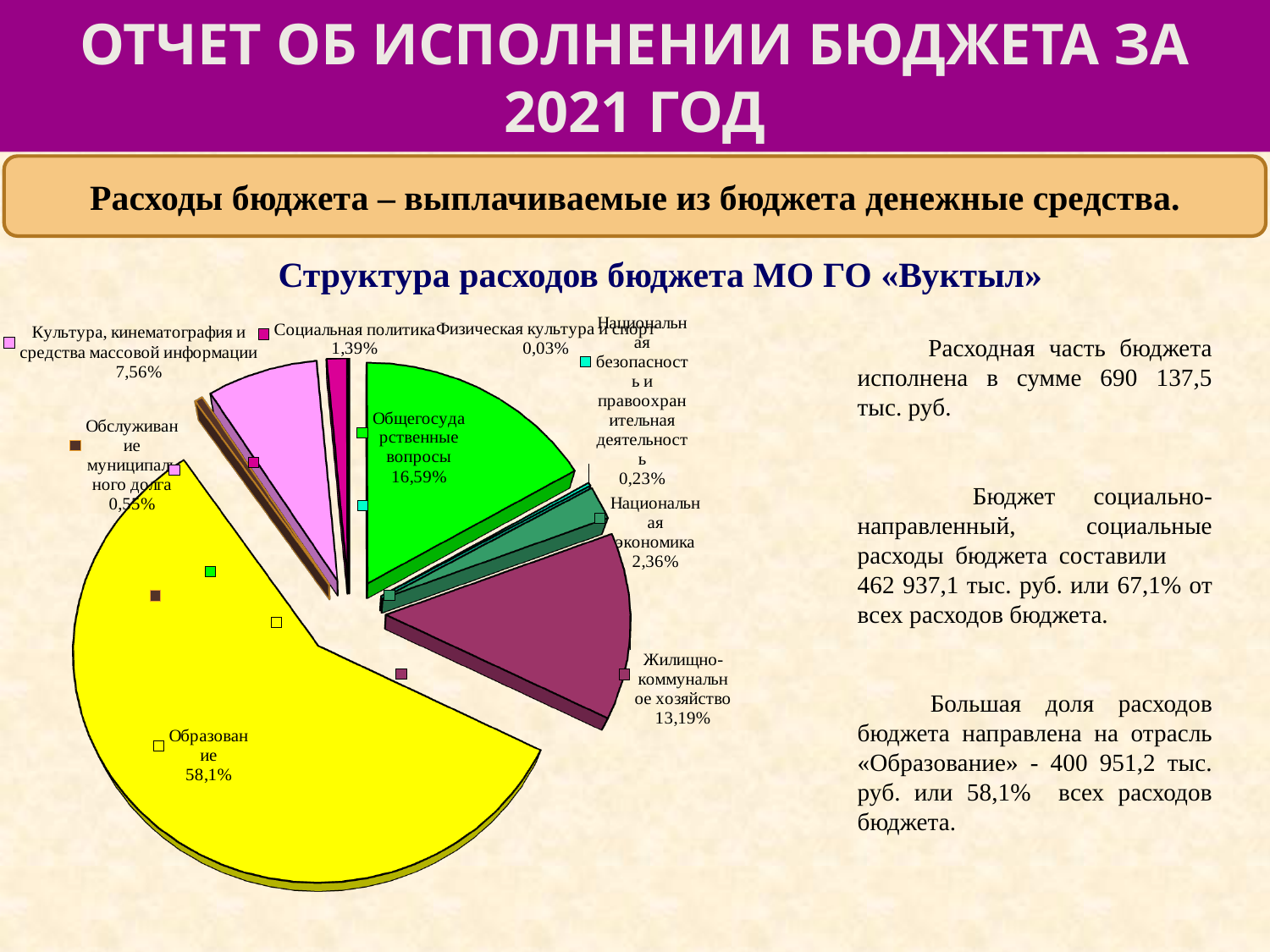
What share of the pie does «Жилищно-коммунальное хозяйство» have? 13,19% What share of the pie does «Культура, кинематография и средства массовой информации» have? 7,56% How many categories are shown in the pie chart? 9 What share of the pie does «Образование» have? 58,1% Which is larger: the share of «Общегосударственные вопросы» or the share of «Жилищно-коммунальное хозяйство»? Общегосударственные вопросы What kind of chart is shown on the slide? pie chart What share of the pie does «Национальная экономика» have? 2,36% Which category has the smallest share of the pie? Физическая культура и спорт What share of the pie does «Общегосударственные вопросы» have? 16,59% Which category has the largest share of the pie? Образование What is the title of the chart? Структура расходов бюджета МО ГО «Вуктыл» What is the difference in percentage points between the shares of «Социальная политика» and «Обслуживание муниципального долга»? 0,84